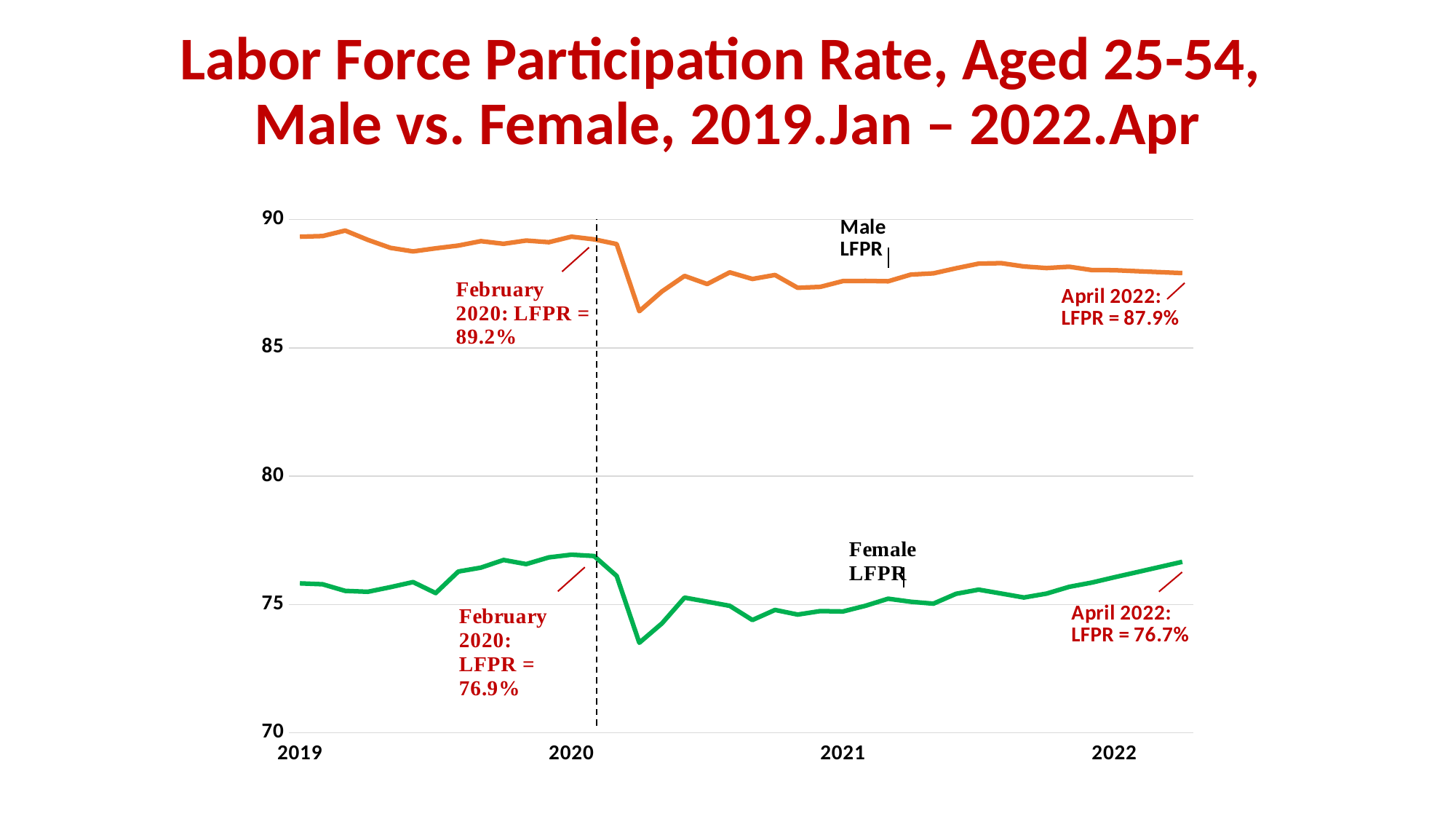
What is the gap between the Male LFPR and the Female LFPR in April 2022? 11.2 percentage points At its lowest point in 2020, is the Female LFPR greater or less than 75? less Which series is higher in April 2022, Male LFPR or Female LFPR? Male LFPR What kind of chart is shown on the slide? line chart By how many percentage points did the Female LFPR change from February 2020 to April 2022? -0.2 percentage points (a fall of 0.2 percentage points) How many series are plotted on the chart? 2 Does the Female LFPR rise or fall from the start of 2021 to April 2022? rise By how many percentage points did the Male LFPR fall from February 2020 to April 2022? 1.3 percentage points What was the Female LFPR in April 2022 according to the annotation? 76.7% What was the Male LFPR in February 2020 according to the annotation? 89.2% What was the Female LFPR in February 2020 according to the annotation? 76.9% What was the Male LFPR in April 2022 according to the annotation? 87.9%